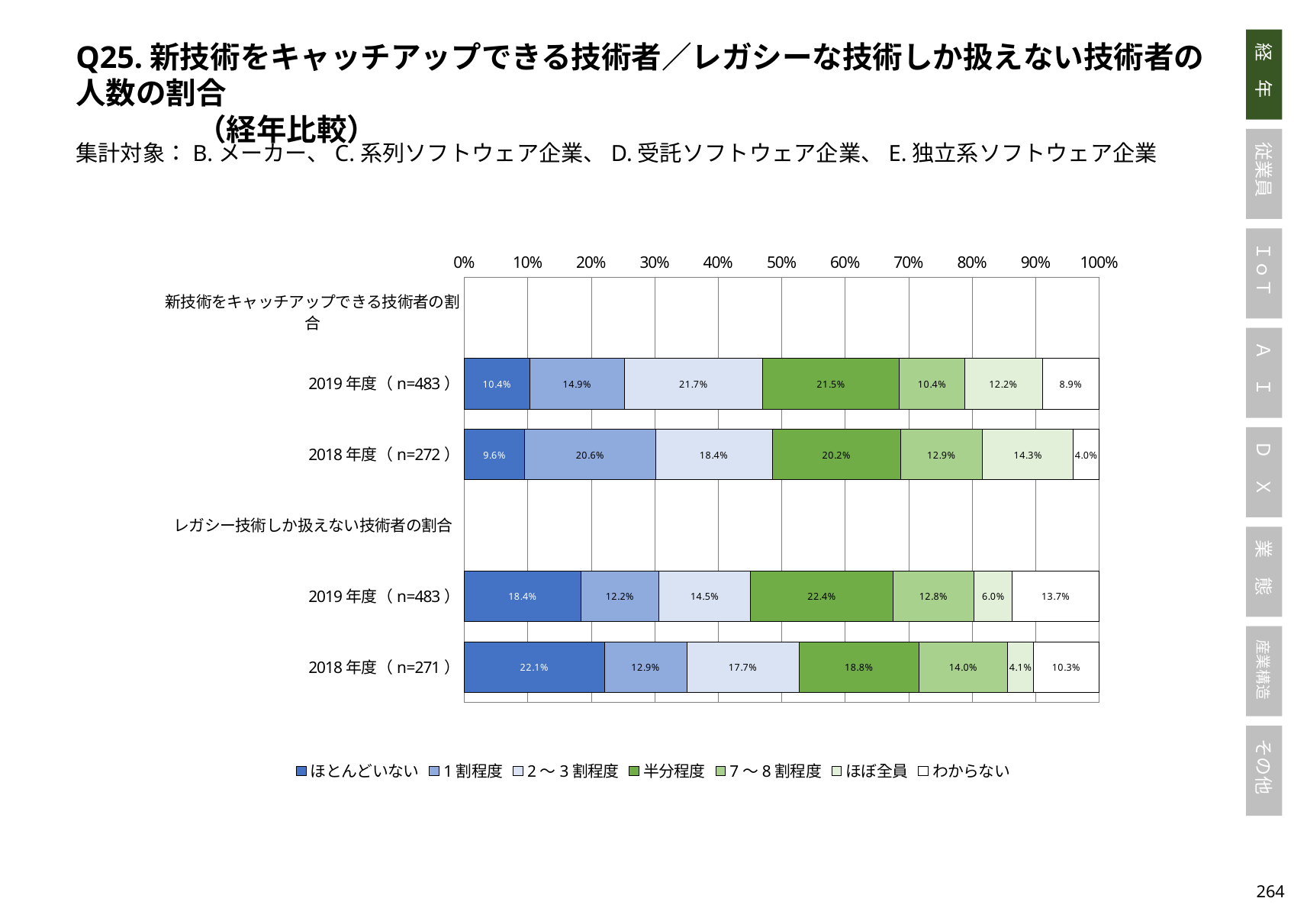
How many series does the legend list? 7 For レガシー技術しか扱えない技術者の割合, what is the value of ほとんどいない in 2018年度 (n=271)? 22.1% What type of chart is shown on the slide? Stacked bar chart In the 2019年度 (n=483) bar for レガシー技術しか扱えない技術者の割合, which segment is the largest? 半分程度 For レガシー技術しか扱えない技術者の割合, what is the difference in ほとんどいない between 2018年度 (22.1%) and 2019年度 (18.4%)? 3.7% For レガシー技術しか扱えない技術者の割合, what is the value of ほぼ全員 in 2019年度 (n=483)? 6.0% How many data bars (year rows) are plotted in the chart? 4 For 新技術をキャッチアップできる技術者の割合, which is larger: 1割程度 in 2019年度 or 1割程度 in 2018年度? 2018年度 In the 2018年度 (n=271) bar for レガシー技術しか扱えない技術者の割合, which segment is the smallest? ほぼ全員 For 新技術をキャッチアップできる技術者の割合, what is the value of わからない in 2018年度 (n=272)? 4.0% For 新技術をキャッチアップできる技術者の割合, what is the value of 半分程度 in 2019年度 (n=483)? 21.5% What is the sample size (n) shown for the 2018年度 row of レガシー技術しか扱えない技術者の割合? n=271